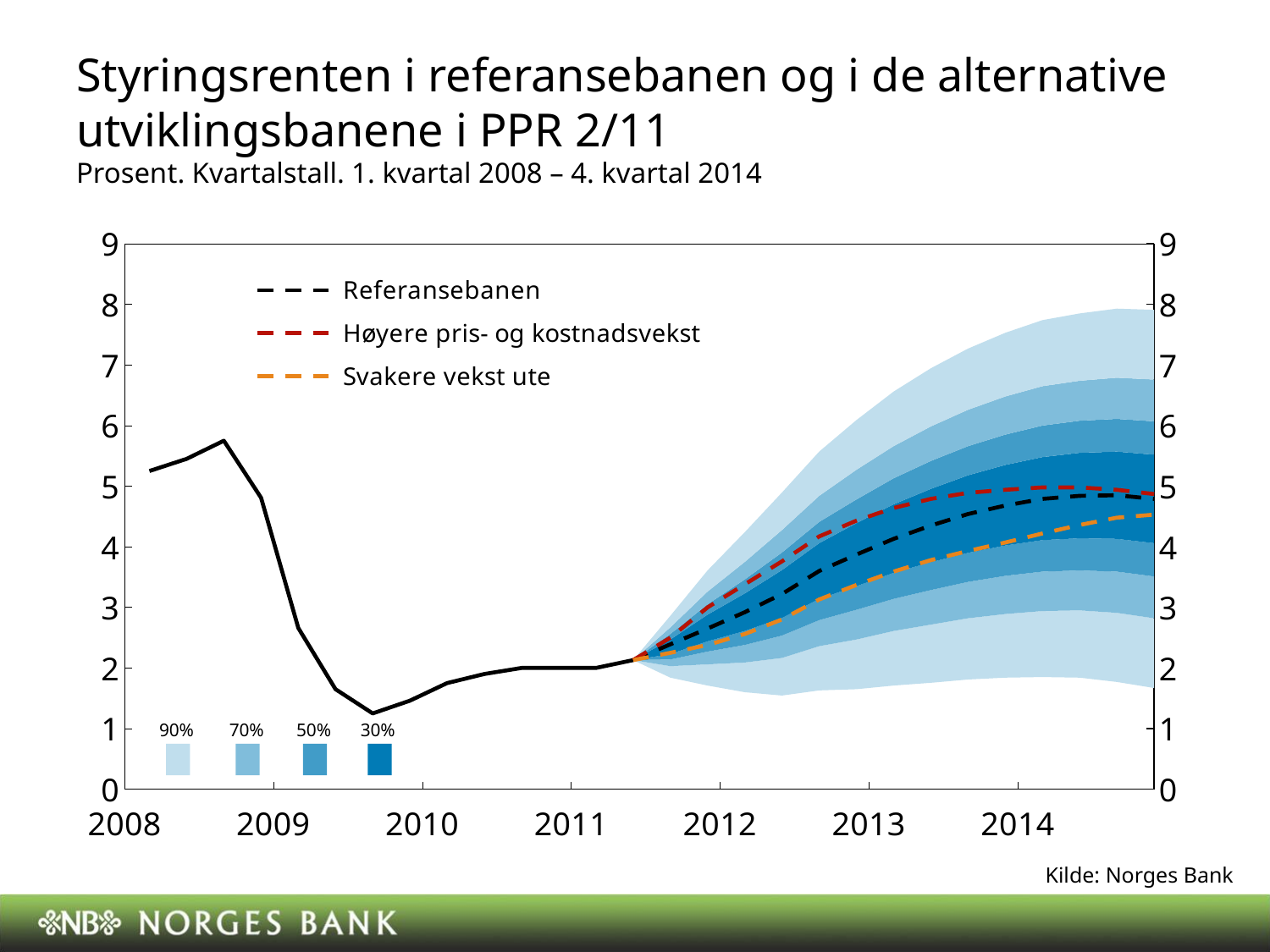
Is the value of Høyere pris- og kostnadsvekst at the start of 2013 greater or less than 4? greater What source is cited for the chart? Norges Bank Does the solid line rise or fall from its 2008 peak to the end of 2009? fall Is the lowest value of the solid line, reached in 2009, greater or less than 2? less Is the value of the solid line at the start of 2008 greater or less than 4? greater What kind of chart is shown on the slide? line chart Does the Referansebanen line rise or fall from mid-2011 to 2014? rise At the start of 2013, which is higher: Referansebanen or Svakere vekst ute? Referansebanen At the end of 2014, which is higher: Høyere pris- og kostnadsvekst or Svakere vekst ute? Høyere pris- og kostnadsvekst How many series does the legend list? 3 Which series does the black dashed line represent? Referansebanen